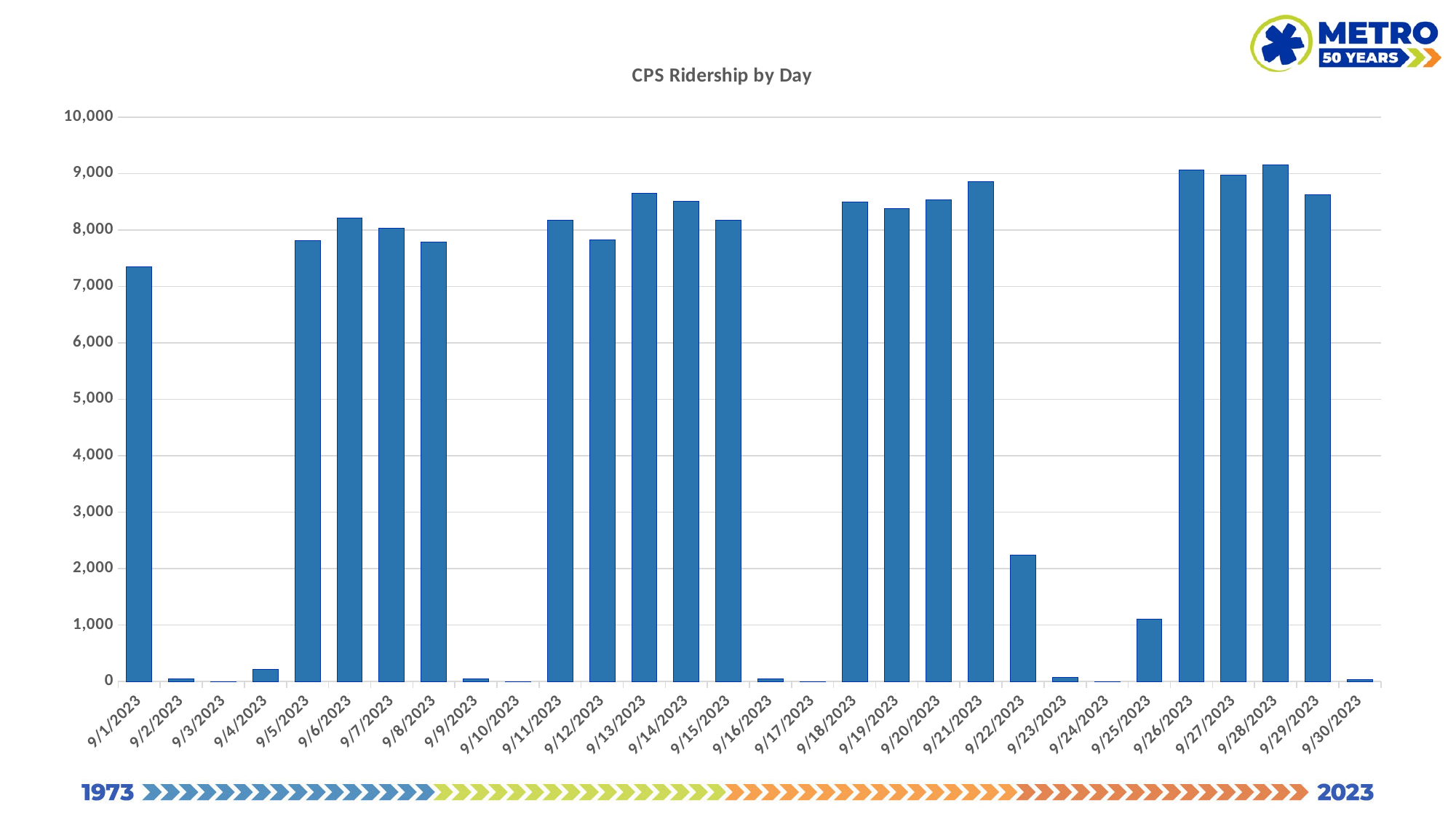
What is the highest value shown on the y axis? 10,000 Which is larger, the value for 9/22/2023 or the value for 9/25/2023? 9/22/2023 Is the value for 9/28/2023 greater or less than 9,000? greater Is the value for 9/13/2023 greater or less than 8,000? greater Is the value for 9/29/2023 greater or less than 9,000? less What kind of chart is shown on the slide? bar chart Which is larger, the value for 9/1/2023 or the value for 9/5/2023? 9/5/2023 What is the title of the chart? CPS Ridership by Day How many days (categories) are plotted on the x axis? 30